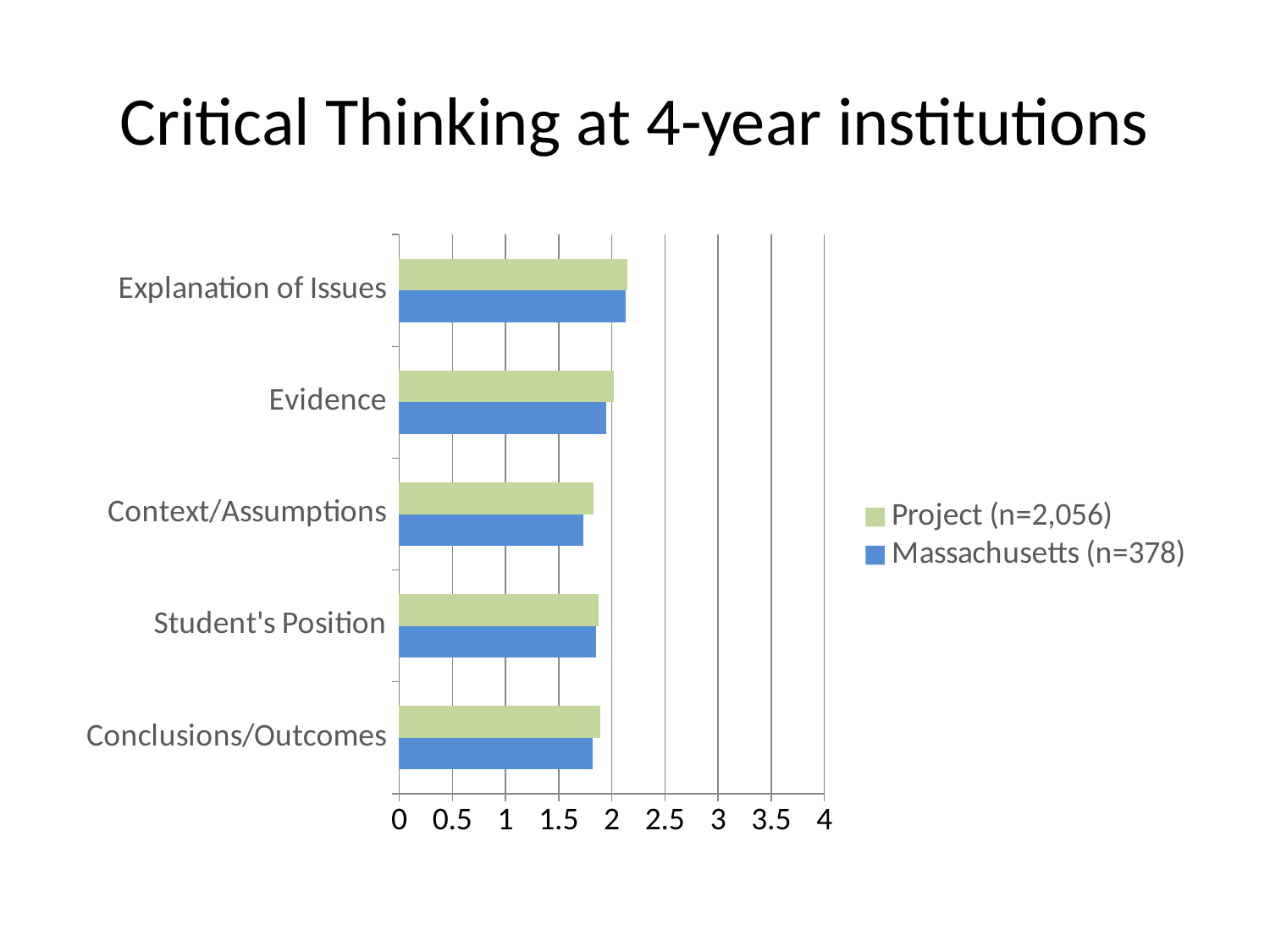
For Project (n=2,056), which is larger: Explanation of Issues or Context/Assumptions? Explanation of Issues Which category has the highest value for Project (n=2,056)? Explanation of Issues Is the Massachusetts (n=378) value for Context/Assumptions greater or less than 2? less Which category has the lowest value for Massachusetts (n=378)? Context/Assumptions What is the title of the chart? Critical Thinking at 4-year institutions How many series does the legend list? 2 Which series is shown in blue in the legend? Massachusetts (n=378) Is the Massachusetts (n=378) value for Conclusions/Outcomes greater or less than 1.5? greater What kind of chart is shown on the slide? bar chart How many categories are shown on the chart? 5 Which category has the highest value for Massachusetts (n=378)? Explanation of Issues Is the Project (n=2,056) value for Explanation of Issues greater or less than 2? greater